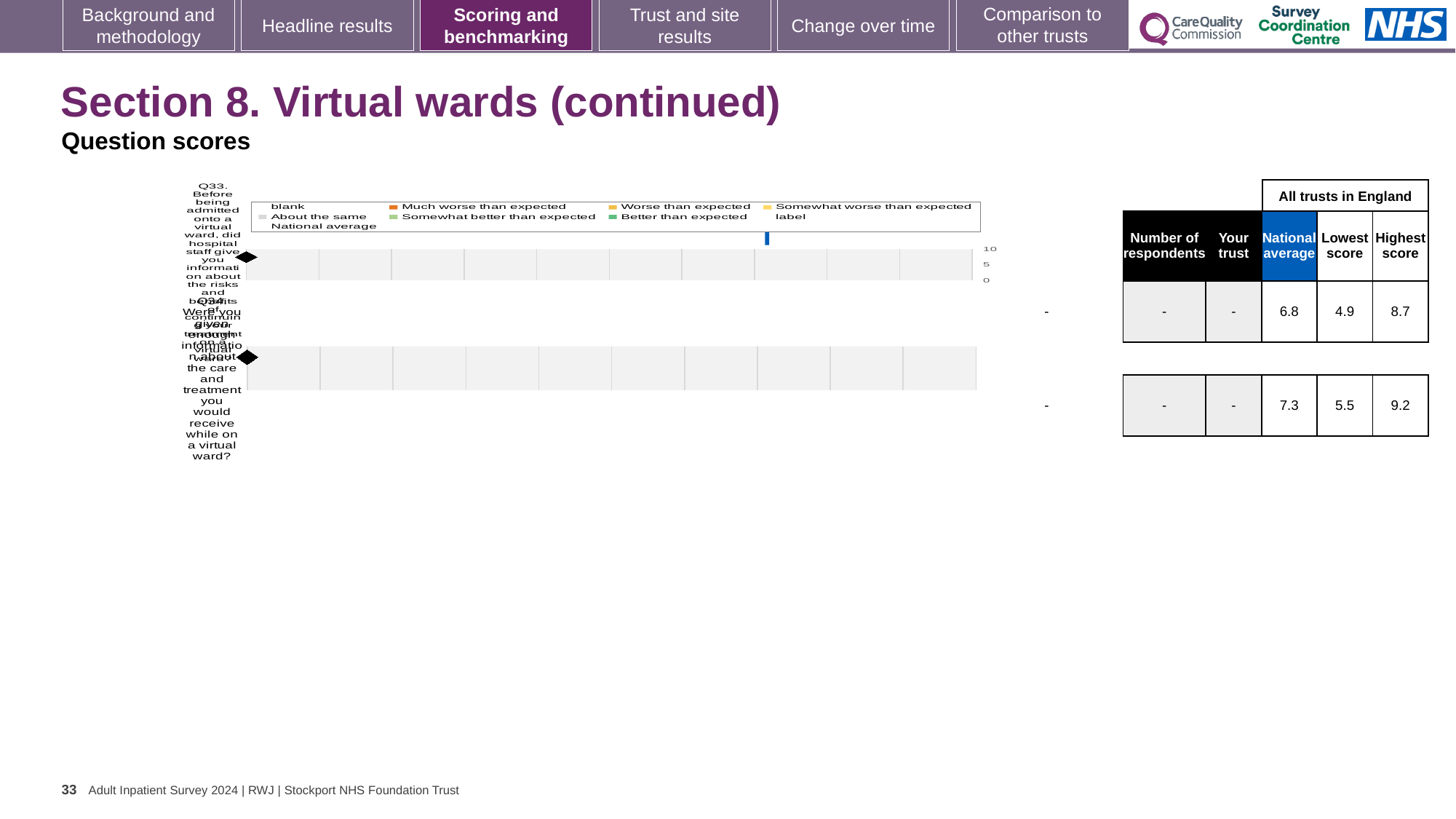
In the table beside the chart, what is the lowest score for Q33? 4.9 In the table beside the chart, what is the highest score for Q34? 9.2 What is the difference between the highest score and the lowest score for Q34? 3.7 How many survey questions (categories) does the chart show? 2 What is the difference between the highest score and the lowest score for Q33? 3.8 In the table beside the chart, what is the national average score for Q33? 6.8 In the table beside the chart, what is the highest score for Q33? 8.7 What is the maximum value shown on the chart's horizontal axis? 10 In the table beside the chart, what is the national average score for Q34? 7.3 What kind of chart is shown on the slide? bar chart In the table beside the chart, what is the lowest score for Q34? 5.5 Which question has the higher national average score, Q33 or Q34? Q34